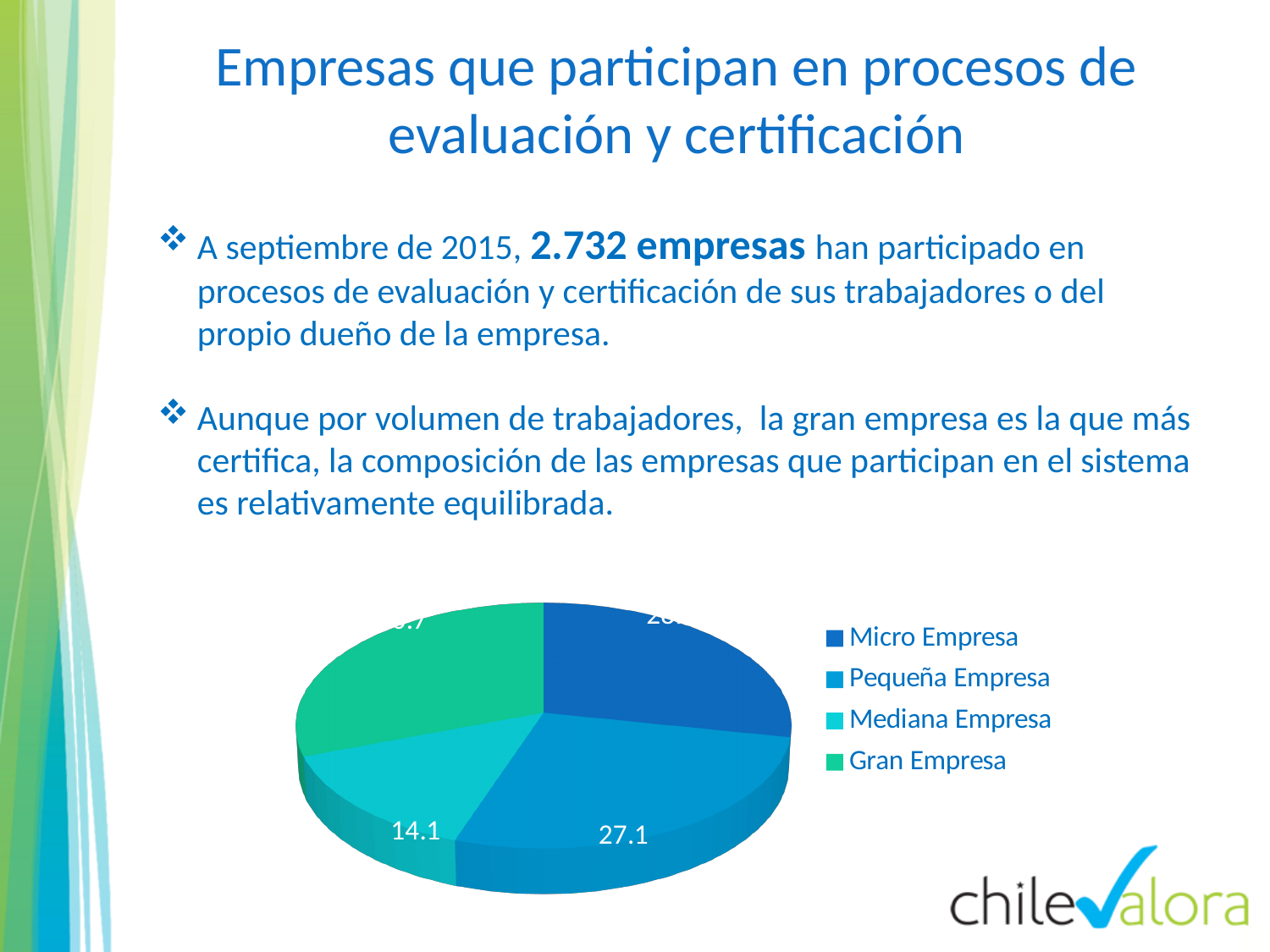
How many slices does the pie chart have? 4 What kind of chart is shown on the slide? Pie chart What is the value shown for Pequeña Empresa in the pie chart? 27.1 Which is larger in the pie chart, Pequeña Empresa or Mediana Empresa? Pequeña Empresa Which category is shown in green in the pie chart? Gran Empresa What is the difference between the values for Pequeña Empresa and Mediana Empresa in the pie chart? 13.0 Which category has the smallest slice in the pie chart? Mediana Empresa What is the value shown for Mediana Empresa in the pie chart? 14.1 Which legend entry is listed first in the pie chart's legend? Micro Empresa How many entries does the legend of the pie chart list? 4